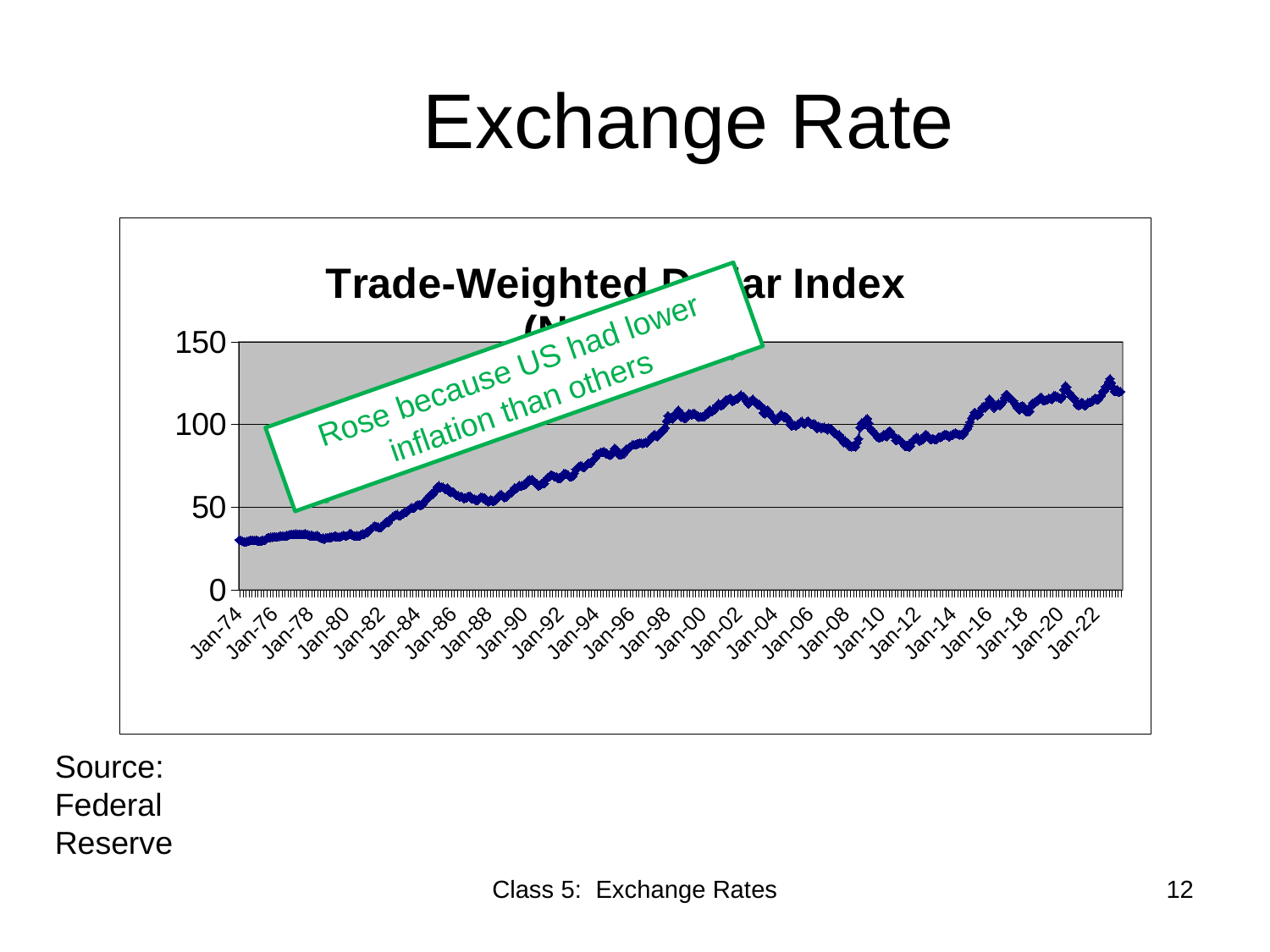
What does the green callout on the chart say? Rose because US had lower inflation than others Is the value of the index at Jan-80 greater or less than 50? less Is the value of the index at Jan-02 greater or less than 100? greater What is the highest value shown on the y axis of the chart? 150 Is the value of the index at Jan-22 greater or less than 100? greater Does the index rise or fall between Jan-02 and Jan-08? fall Which is larger, the index value at Jan-74 or at Jan-22? Jan-22 Overall, does the index rise or fall from Jan-74 to Jan-22? rise What kind of chart is shown on the slide? line chart